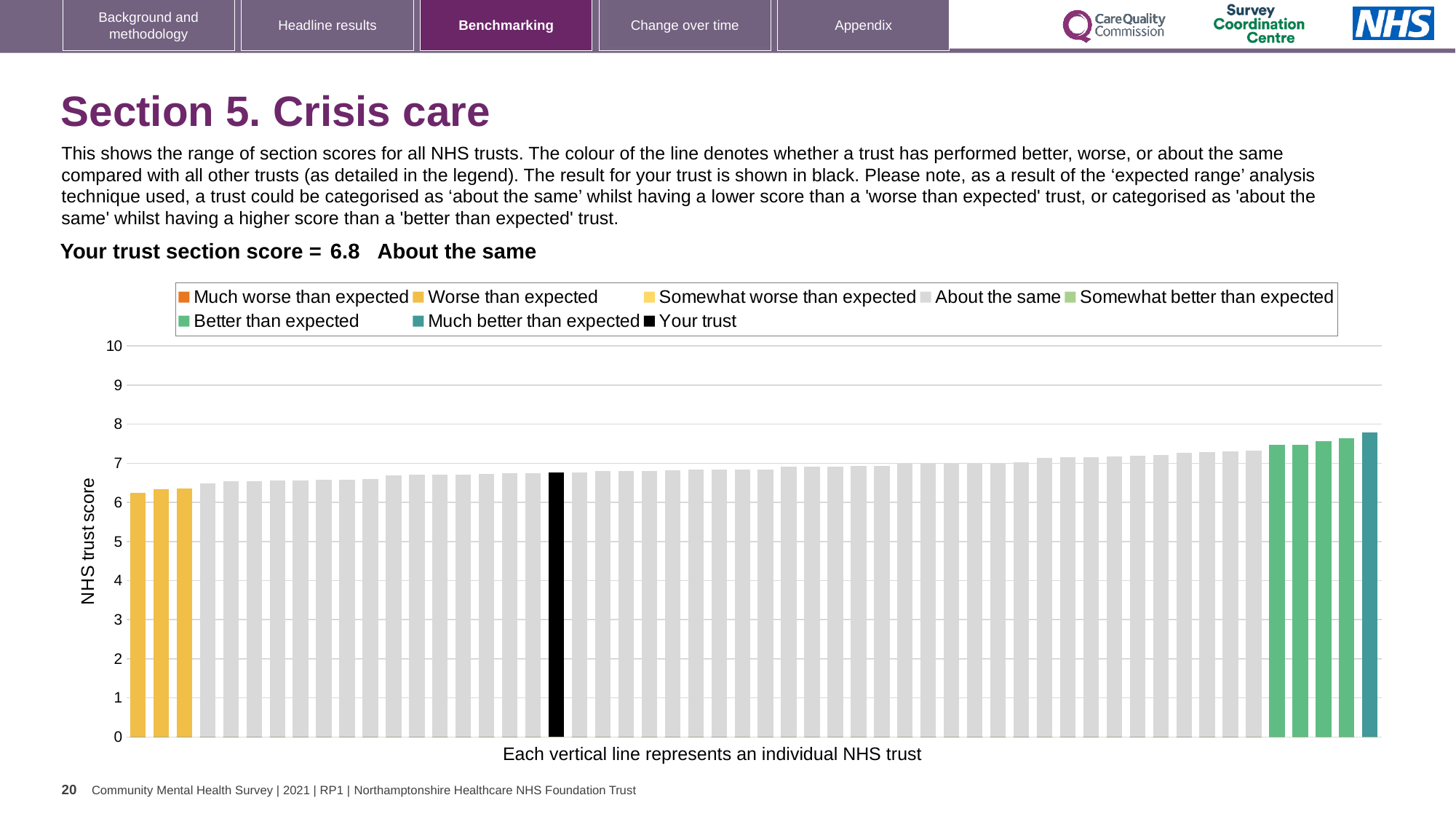
What kind of chart is shown on the slide? bar chart How many bars are coloured as 'Worse than expected' (yellow)? 3 What is the label on the vertical axis of the chart? NHS trust score How many entries does the chart legend list? 8 How many bars are coloured as 'Better than expected' (green)? 4 Is the value of the highest bar in the chart greater or less than 8? less Do the bar values rise or fall from left to right along the x axis? rise How is your trust's section score categorised compared with other trusts? About the same Which bar is larger, the leftmost bar or the rightmost bar? the rightmost bar Is the value for your trust (the black bar) greater or less than 5? greater What is the section score for your trust shown on the slide? 6.8 Is the value of the lowest bar in the chart greater or less than 6? greater